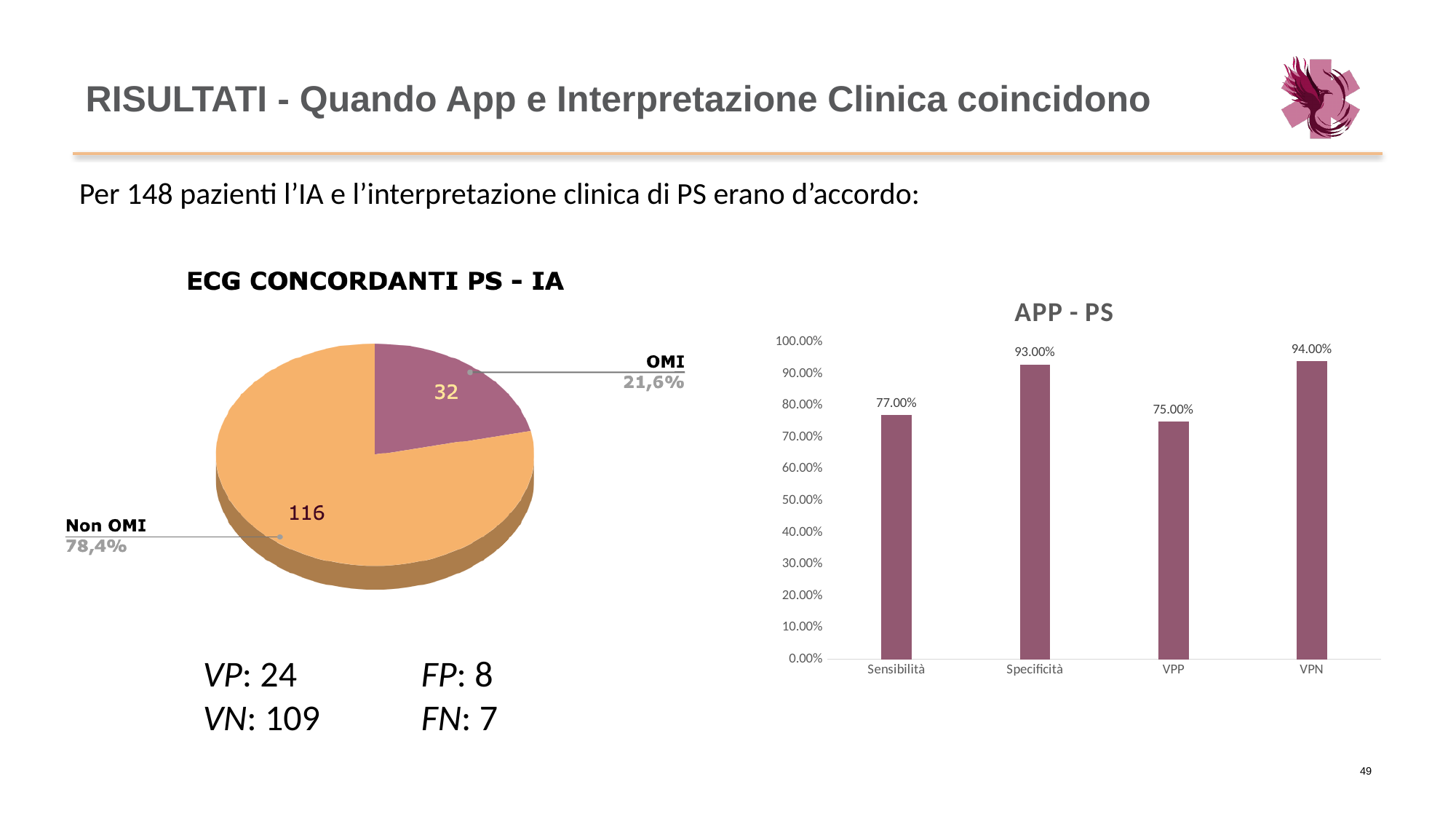
In the 'APP - PS' chart, which category has the lowest value? VPP In the 'ECG CONCORDANTI PS - IA' chart, what share of the pie does OMI represent? 21,6% In the 'ECG CONCORDANTI PS - IA' chart, what is the value for Non OMI? 116 What kind of chart is 'ECG CONCORDANTI PS - IA'? Pie chart In the 'APP - PS' chart, what is the difference between the values for VPN and Sensibilità? 17.00% In the 'ECG CONCORDANTI PS - IA' chart, how many slices are there? 2 In the 'APP - PS' chart, what is the value for Specificità? 93.00% In the 'APP - PS' chart, which category has the highest value? VPN What kind of chart is 'APP - PS'? Bar chart In the 'ECG CONCORDANTI PS - IA' chart, what is the value for OMI? 32 In the 'APP - PS' chart, what is the value for VPP? 75.00% In the 'ECG CONCORDANTI PS - IA' chart, what share of the pie does Non OMI represent? 78,4%